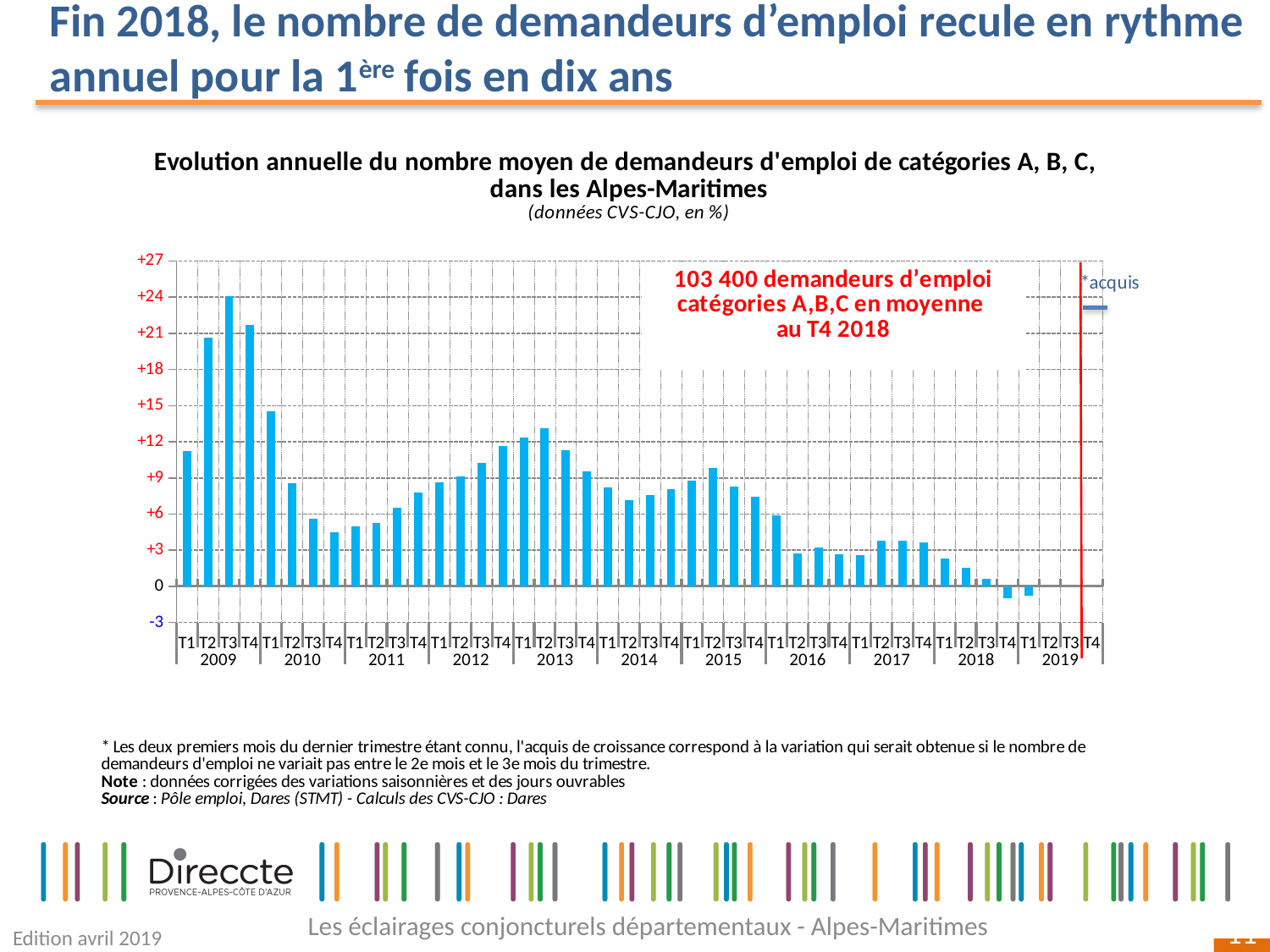
Which is larger, the value for T1 2012 or the value for T1 2016? T1 2012 Which is larger, the value for T3 2009 or the value for T3 2013? T3 2009 What kind of chart is shown on the slide? bar chart Which quarter has the highest value in the chart? T3 2009 Is the value for T3 2009 greater or less than +21? greater How many years are labelled on the x axis of the chart? 11 Is the value for T4 2010 greater or less than +6? less According to the annotation on the chart, how many demandeurs d'emploi catégories A,B,C were there on average at T4 2018? 103 400 Is the value for T4 2015 greater or less than +9? less Do the values generally rise or fall from 2013 to 2018? fall